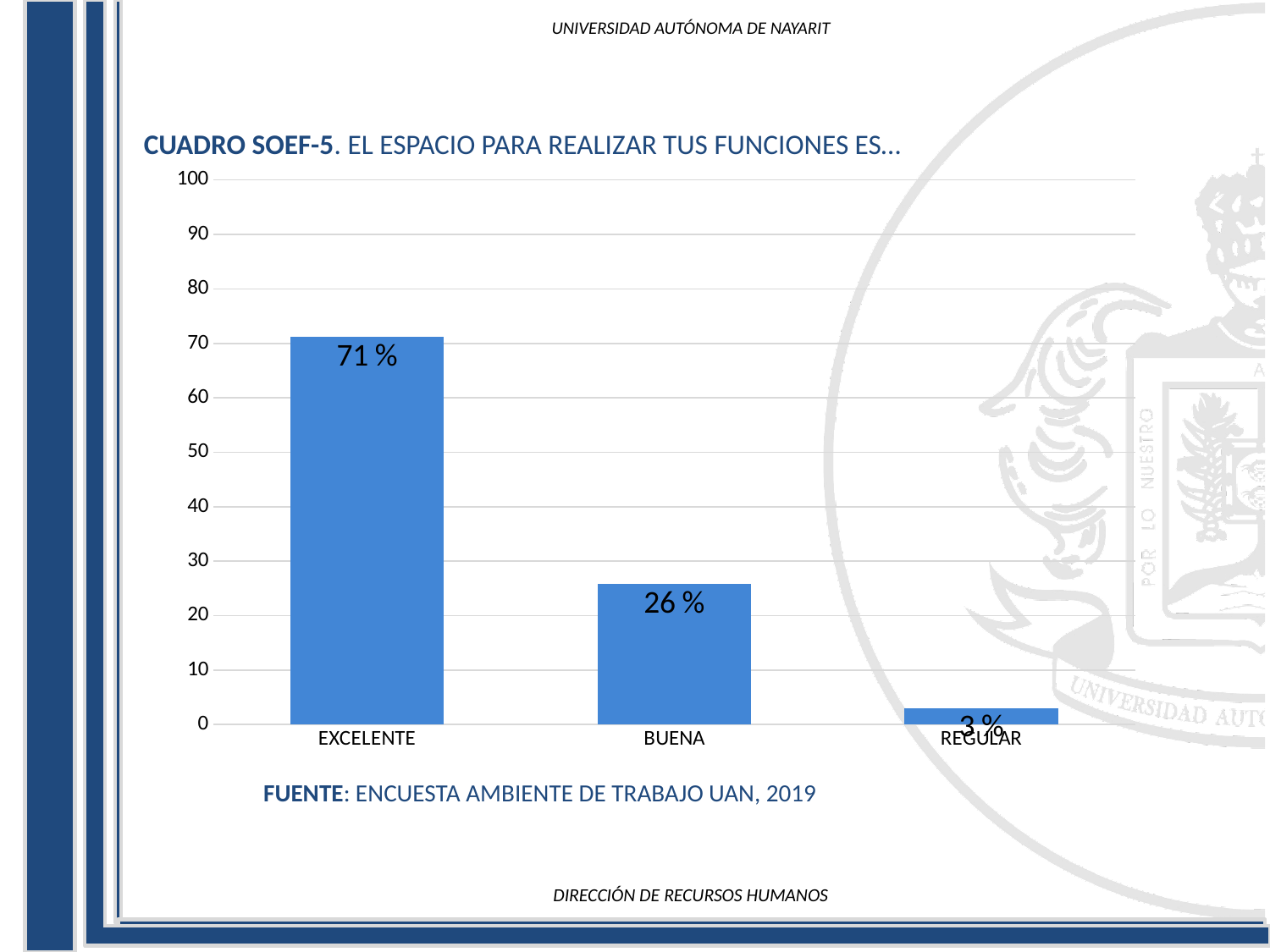
What is the value for REGULAR? 3 % What kind of chart is shown on the slide? bar chart What is the value for EXCELENTE? 71 % Which is larger, the value for BUENA or the value for REGULAR? BUENA Which category has the highest value? EXCELENTE What is the difference between the values for EXCELENTE and BUENA? 45 % What is the difference between the values for BUENA and REGULAR? 23 % How many categories are shown on the x axis? 3 Which category has the lowest value? REGULAR What is the value for BUENA? 26 % Do the values rise or fall from left to right along the x axis? fall Is the value for EXCELENTE greater or less than 60? greater